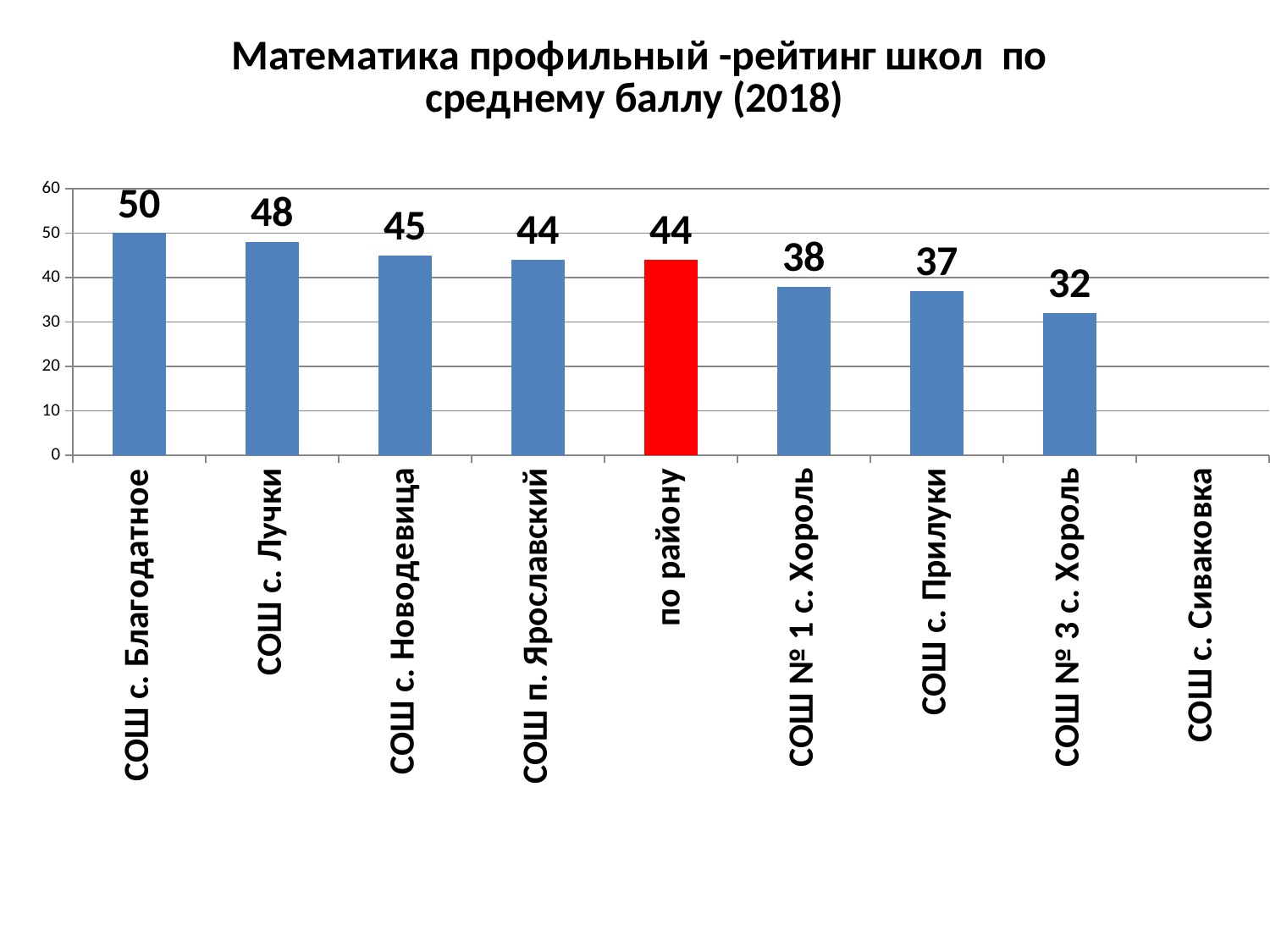
Which category with a plotted bar has the lowest value? СОШ № 3 с. Хороль Which category has the highest value? СОШ с. Благодатное What is the difference between the values for СОШ с. Благодатное and СОШ № 3 с. Хороль? 18 What is the value for СОШ № 3 с. Хороль? 32 What kind of chart is shown on the slide? bar chart What is the value for СОШ с. Благодатное? 50 How many categories are labelled on the x axis? 9 What is the value for СОШ с. Лучки? 48 Which bar is coloured red? по району What is the value for по району? 44 Which is larger, the value for СОШ с. Новодевица or the value for СОШ п. Ярославский? СОШ с. Новодевица What is the difference between the values for СОШ № 1 с. Хороль and СОШ с. Прилуки? 1